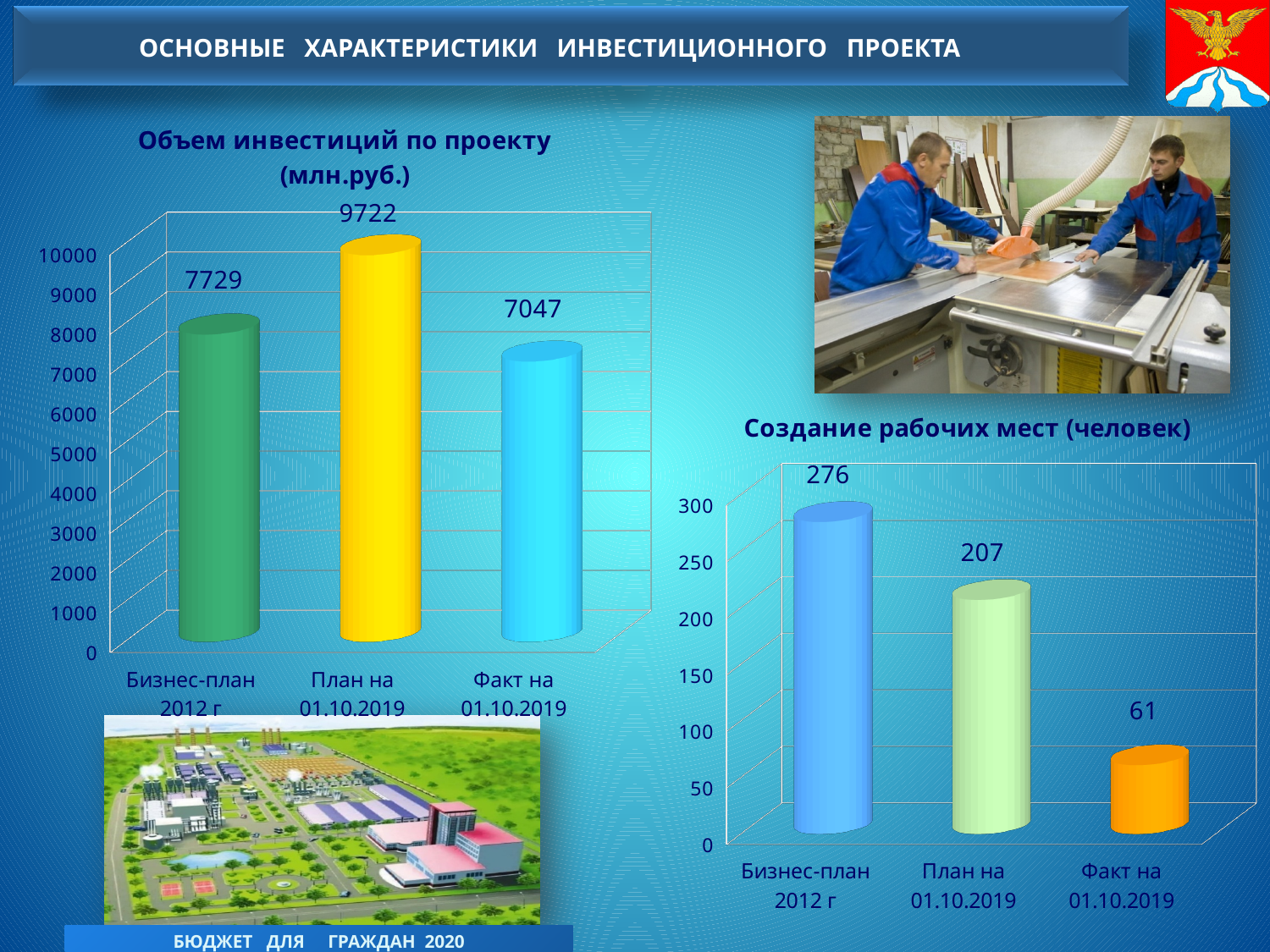
What kind of chart is 'Создание рабочих мест (человек)'? bar chart In the chart 'Создание рабочих мест (человек)', what is the value for 'План на 01.10.2019'? 207 In the chart 'Объем инвестиций по проекту (млн.руб.)', which category has the lowest value? Факт на 01.10.2019 In the chart 'Объем инвестиций по проекту (млн.руб.)', what is the value for 'Бизнес-план 2012 г'? 7729 In the chart 'Создание рабочих мест (человек)', what is the value for 'Факт на 01.10.2019'? 61 In the chart 'Объем инвестиций по проекту (млн.руб.)', which category has the highest value? План на 01.10.2019 In the chart 'Объем инвестиций по проекту (млн.руб.)', what is the value for 'План на 01.10.2019'? 9722 In the chart 'Создание рабочих мест (человек)', do the values rise or fall from left to right along the x axis? fall In the chart 'Объем инвестиций по проекту (млн.руб.)', what is the difference between 'План на 01.10.2019' and 'Факт на 01.10.2019'? 2675 In the chart 'Создание рабочих мест (человек)', which category has the highest value? Бизнес-план 2012 г In the chart 'Создание рабочих мест (человек)', what is the difference between 'Бизнес-план 2012 г' and 'План на 01.10.2019'? 69 In the chart 'Объем инвестиций по проекту (млн.руб.)', how many categories are shown? 3